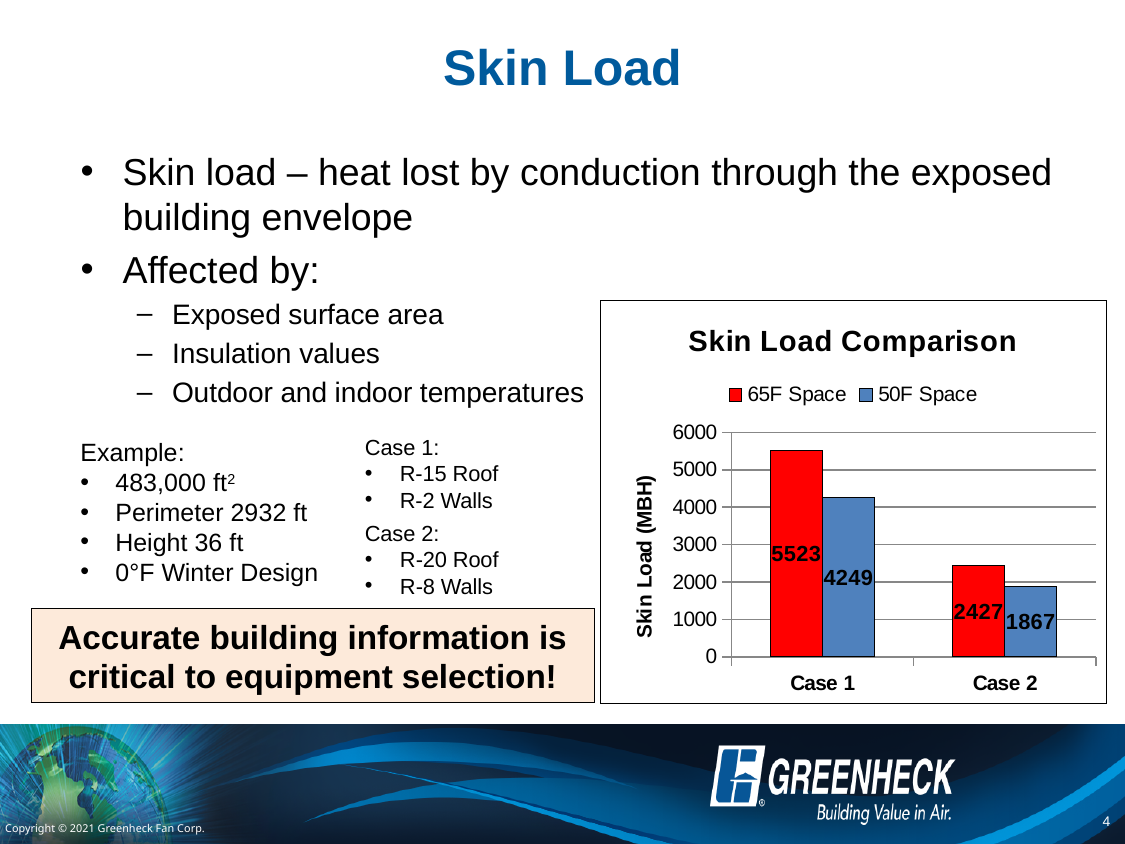
What is the difference between the 65F Space and 50F Space values in Case 1? 1274 What is the Skin Load (MBH) for 65F Space in Case 1? 5523 What is the difference between the 65F Space values for Case 1 and Case 2? 3096 What type of chart is the Skin Load Comparison? Bar chart Which is larger in Case 2: the 65F Space value or the 50F Space value? 65F Space What is the Skin Load (MBH) for 50F Space in Case 2? 1867 How many series does the chart legend list? 2 What is the Skin Load (MBH) for 50F Space in Case 1? 4249 Is the 50F Space value for Case 1 greater or less than 4000? greater Which case has the highest 65F Space skin load? Case 1 How many cases are shown on the x axis of the chart? 2 Which case has the lowest 50F Space skin load? Case 2